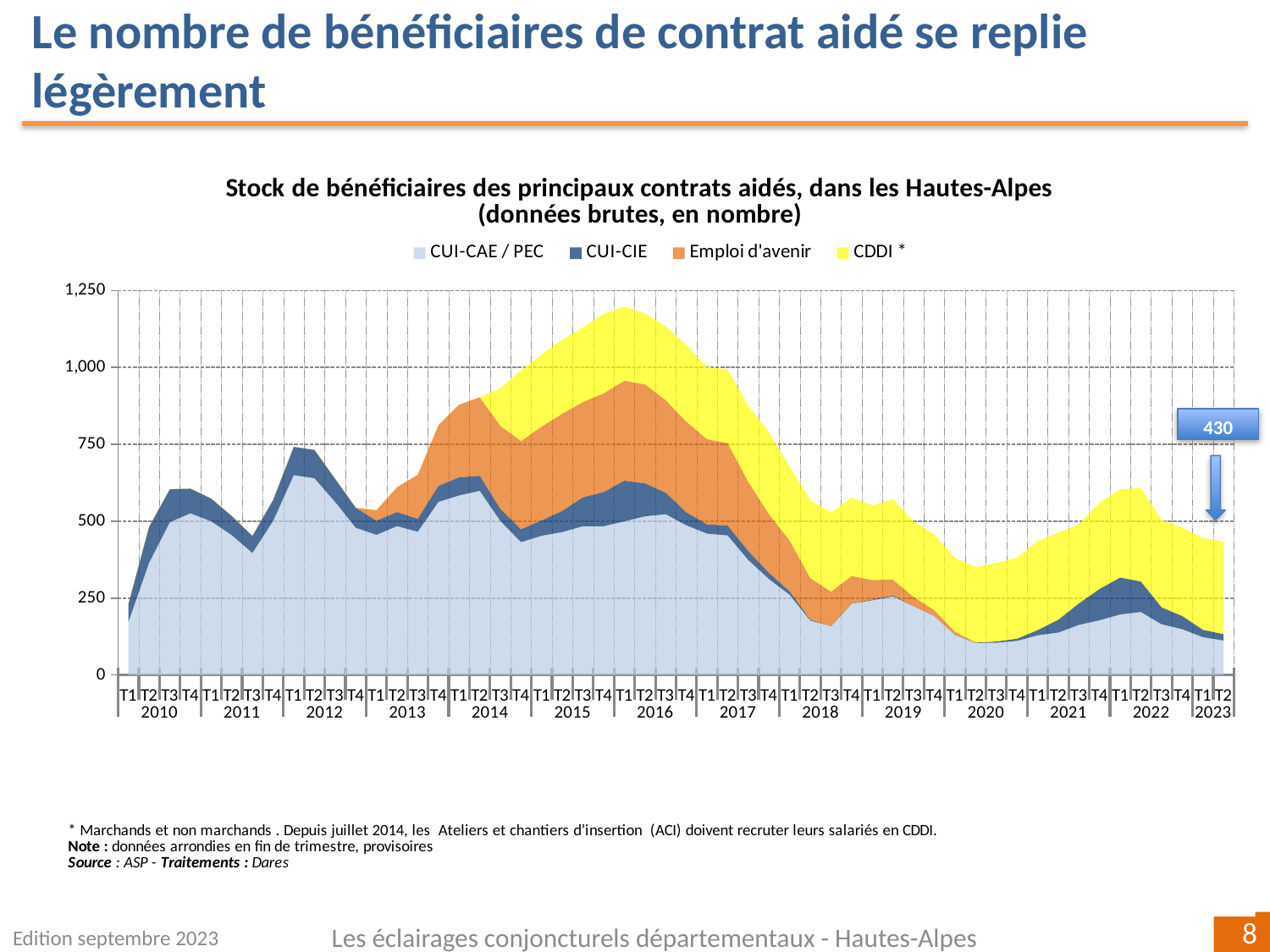
How many series does the legend list? 4 Is the total stock of beneficiaries at T3 2020 greater or less than 500? less In which year does the total stock of beneficiaries reach its highest level? 2016 How many years are shown along the x axis? 14 What total value is labelled at the end of the series, for T2 2023? 430 Is the total stock of beneficiaries at T1 2014 greater or less than 750? greater Which colour represents the CDDI * series in the legend? Yellow What kind of chart is shown on the slide? Stacked area chart Does the total stock of beneficiaries rise or fall between T1 2016 and T2 2023? fall Is the peak total stock of beneficiaries reached in 2016 greater or less than 1,000? greater Which series is plotted at the bottom of the stacked areas? CUI-CAE / PEC